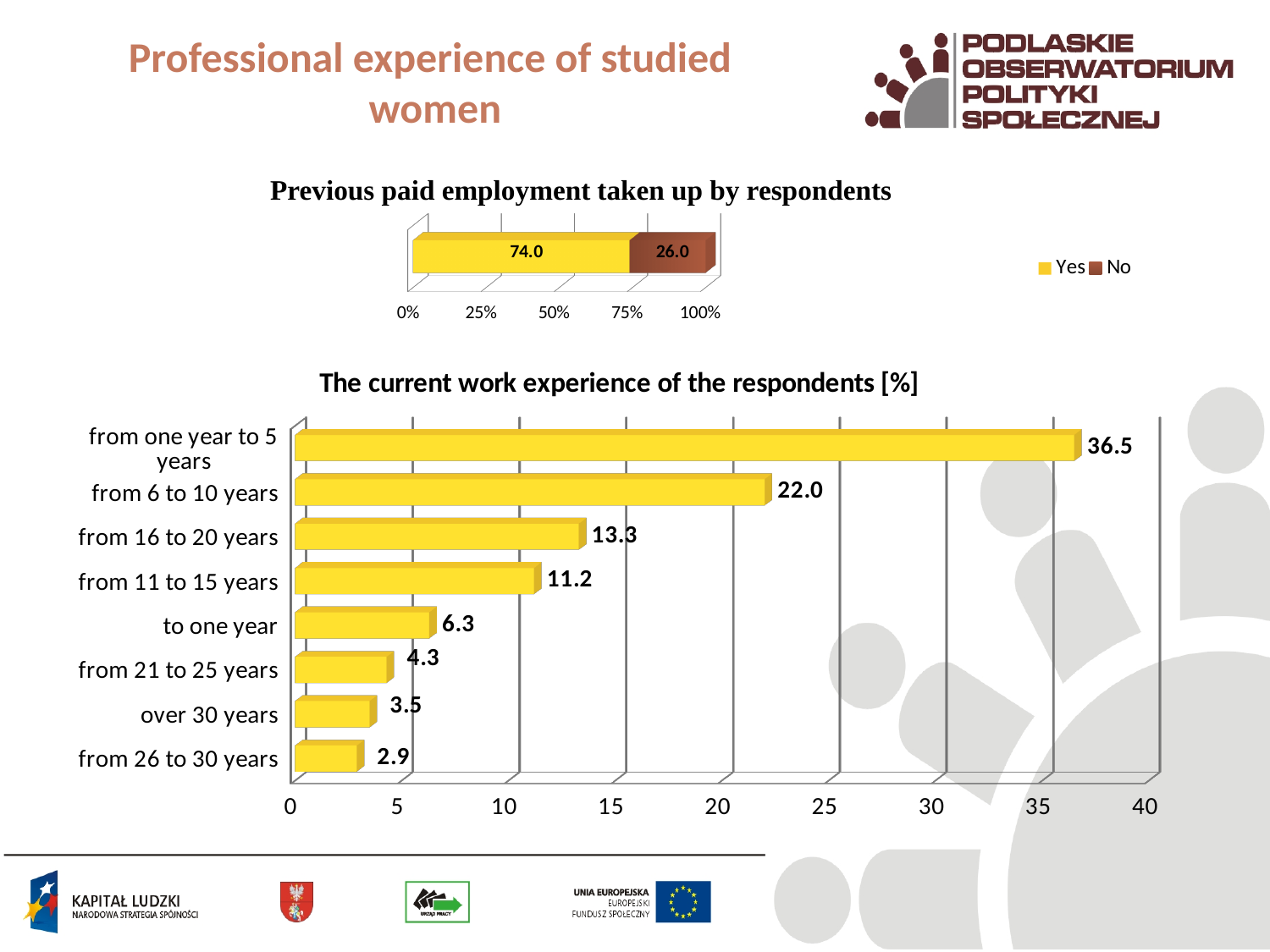
In the chart 'The current work experience of the respondents [%]', what is the difference between 'from 16 to 20 years' and 'from 11 to 15 years'? 2.1 In the chart 'The current work experience of the respondents [%]', what is the value for 'to one year'? 6.3 In the chart 'The current work experience of the respondents [%]', which is larger: 'over 30 years' or 'from 21 to 25 years'? from 21 to 25 years In the chart 'The current work experience of the respondents [%]', which category has the highest value? from one year to 5 years In the chart 'The current work experience of the respondents [%]', which category has the lowest value? from 26 to 30 years In the chart 'Previous paid employment taken up by respondents', what is the value for No? 26.0 In the chart 'The current work experience of the respondents [%]', how many categories are shown? 8 In the chart 'The current work experience of the respondents [%]', what is the value for 'from 6 to 10 years'? 22.0 In the chart 'Previous paid employment taken up by respondents', what is the difference between the Yes and No values? 48.0 In the chart 'Previous paid employment taken up by respondents', how many series does the legend list? 2 What kind of chart is 'The current work experience of the respondents [%]'? bar chart In the chart 'Previous paid employment taken up by respondents', what is the value for Yes? 74.0